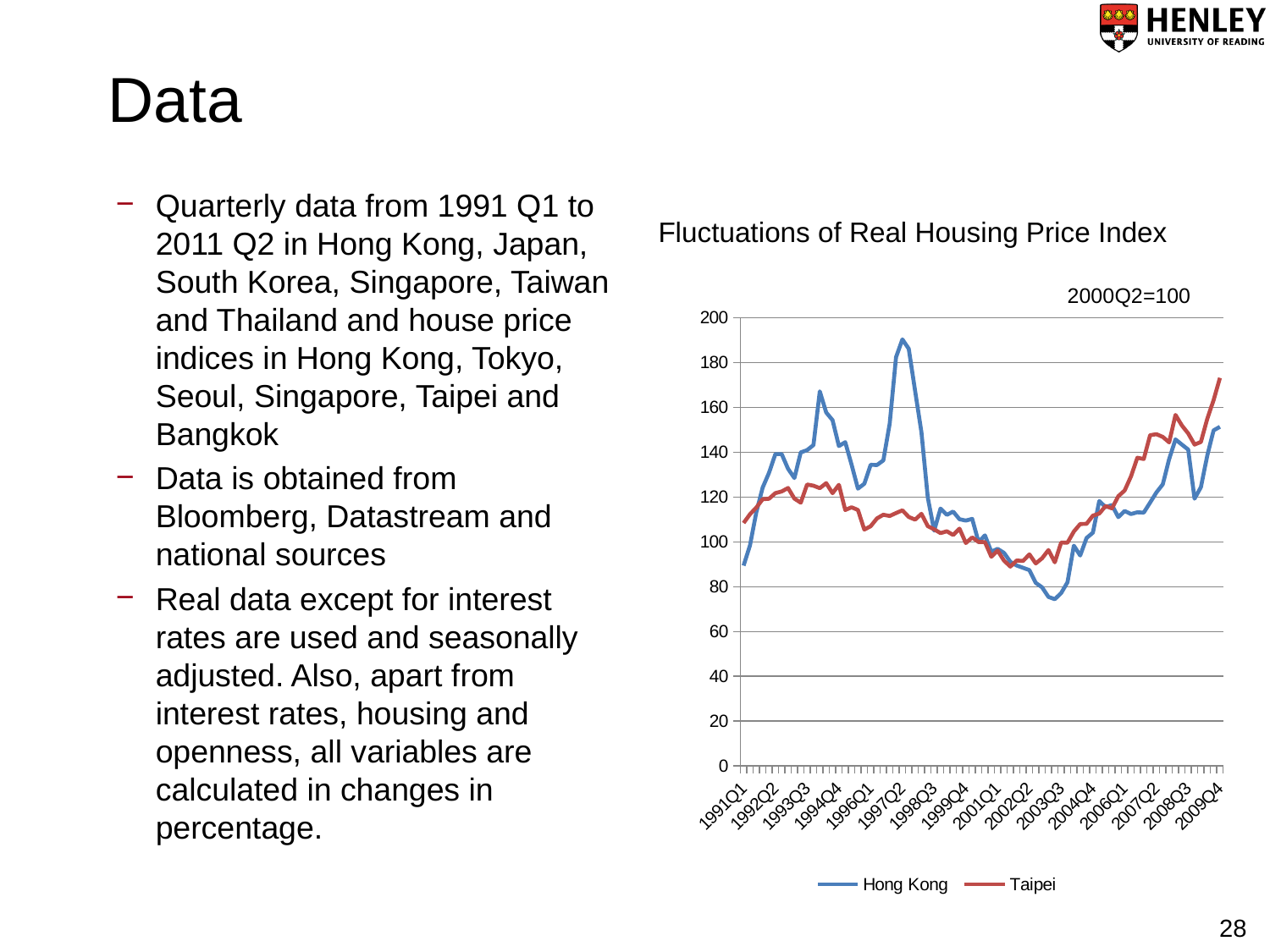
Is the peak value of the Hong Kong series around 1997Q2 greater or less than 180? greater Which series is higher around 1997Q2, Hong Kong or Taipei? Hong Kong What is the title of the chart on the slide? Fluctuations of Real Housing Price Index Is the value of the Taipei series at the end of the chart (2009Q4) greater or less than 160? greater What kind of chart is shown on the slide? Line chart Which quarter is used as the base period (=100) for the index in the chart? 2000Q2 Is the value of the Hong Kong series at 1991Q1 greater or less than 100? less Which series is higher around 2003Q3, Hong Kong or Taipei? Taipei How many series does the legend of the chart list? 2 Does the Hong Kong series rise or fall between 1997Q2 and 2003Q3? fall Which series reaches the highest value anywhere on the chart? Hong Kong